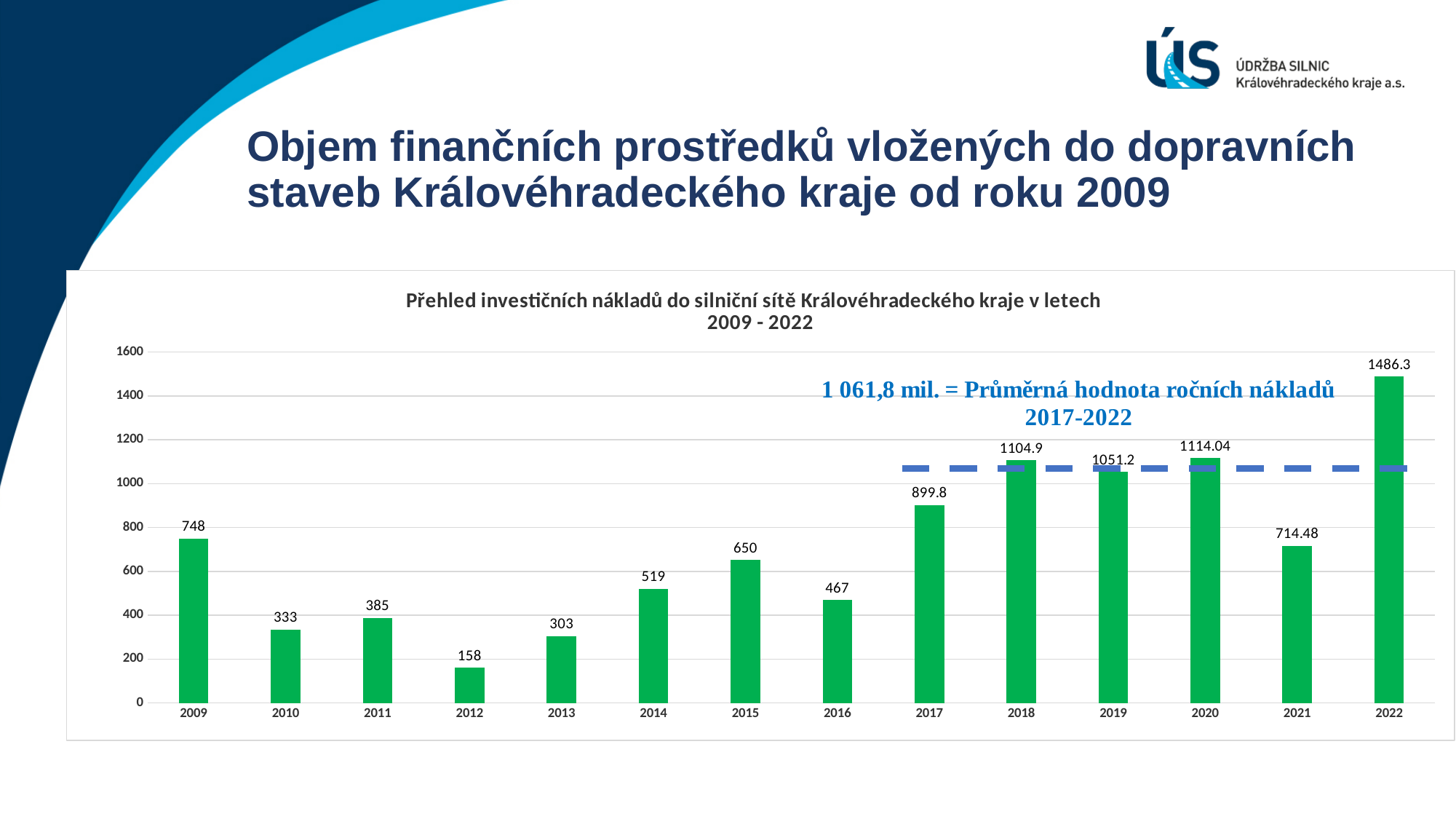
What is the value for 2020? 1114.04 What is the value for 2009? 748 Is the value for 2017 greater or less than 1000? less Which year has the lowest value? 2012 What is the value for 2022? 1486.3 How many years are shown on the x axis? 14 Do the values rise or fall from 2012 to 2015? rise Which year has the highest value? 2022 What is the difference between the values for 2022 and 2021? 771.82 What kind of chart is shown on the slide? bar chart What average value for 2017-2022 is stated next to the dashed line? 1 061,8 mil. Which is larger, the value for 2015 or the value for 2016? 2015